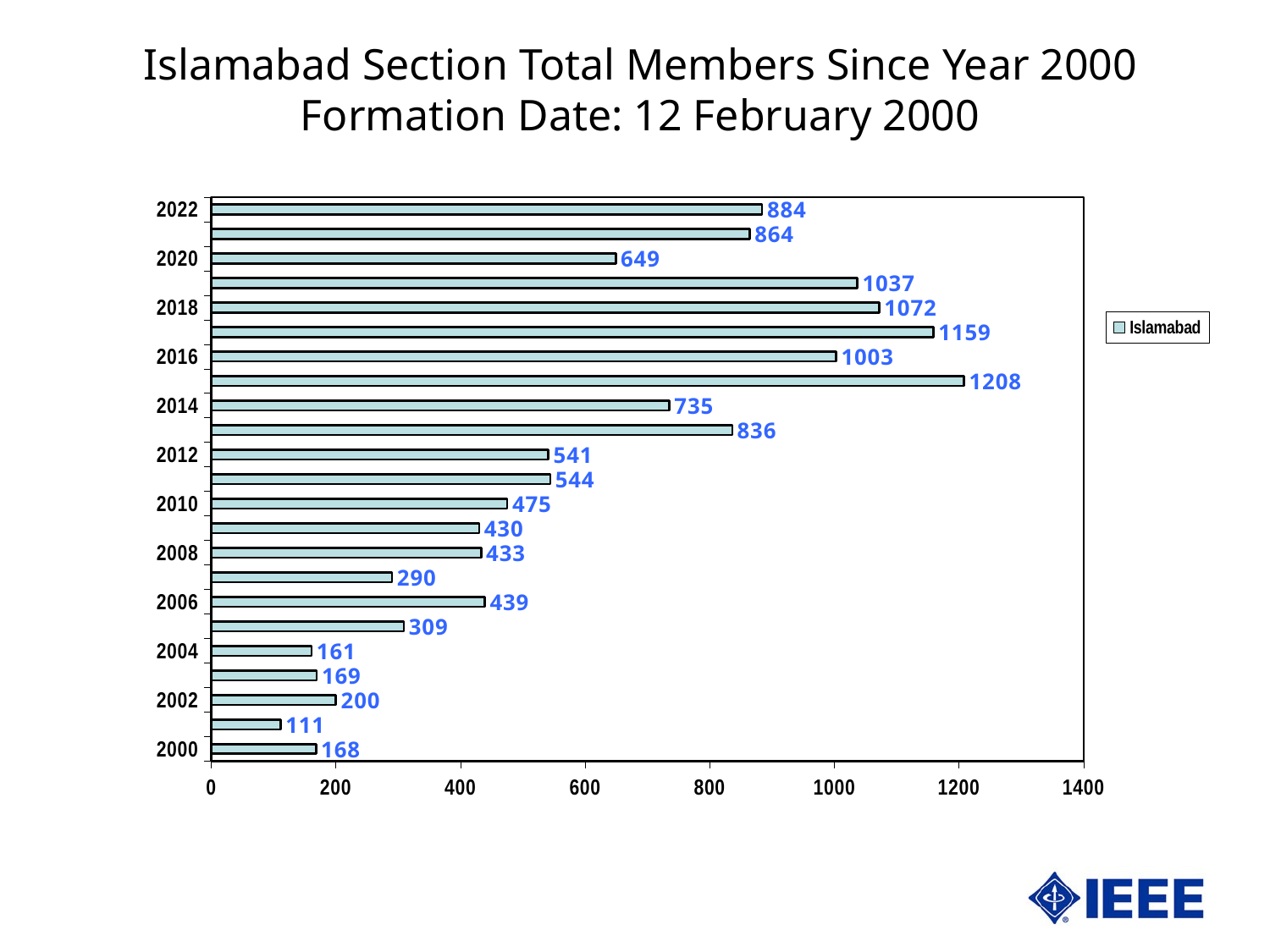
What is the series name shown in the legend? Islamabad What is the highest value shown on the chart? 1208 What is the difference between the values for 2018 and 2020? 423 What is the value for 2022? 884 How many series does the legend list? 1 What is the value for 2016? 1003 How many bars are plotted on the chart? 23 Which is larger, the value for 2012 or the value for 2014? 2014 What kind of chart is shown? bar chart What is the value for 2010? 475 What is the lowest value shown on the chart? 111 What is the value for 2000? 168